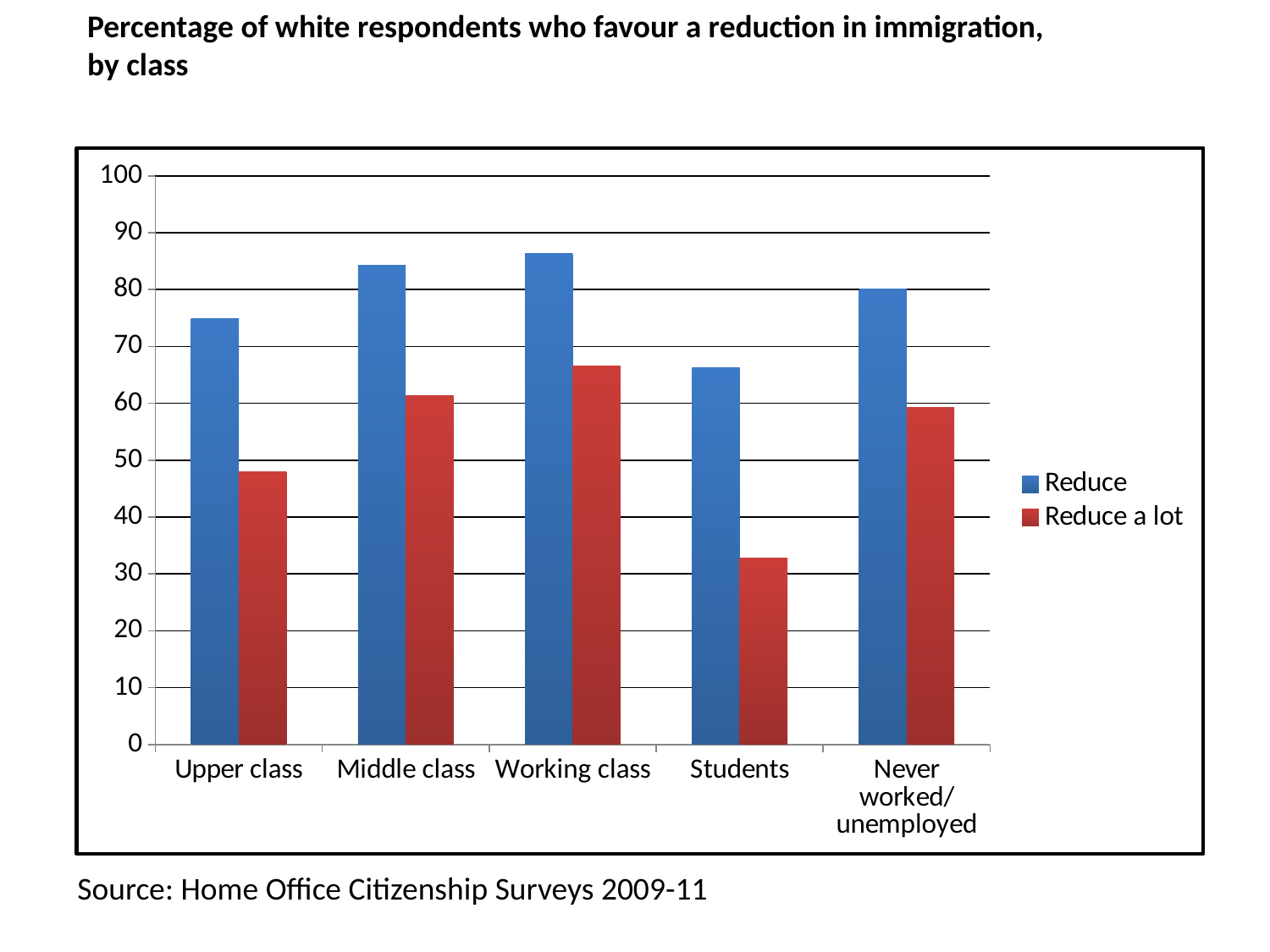
Is the Reduce a lot value for Middle class greater or less than 70? less Is the Reduce value for Upper class greater or less than 70? greater How many series does the legend list? 2 What colour are the bars for the Reduce a lot series? red Is the Reduce a lot value for Students greater or less than 40? less Which category has the lowest value for the Reduce series? Students Which category has the highest value for the Reduce a lot series? Working class Which is larger: the Reduce value for Upper class or the Reduce value for Never worked/unemployed? Never worked/unemployed Which category has the lowest value for the Reduce a lot series? Students How many class categories are shown on the x axis? 5 What kind of chart is shown on the slide? bar chart